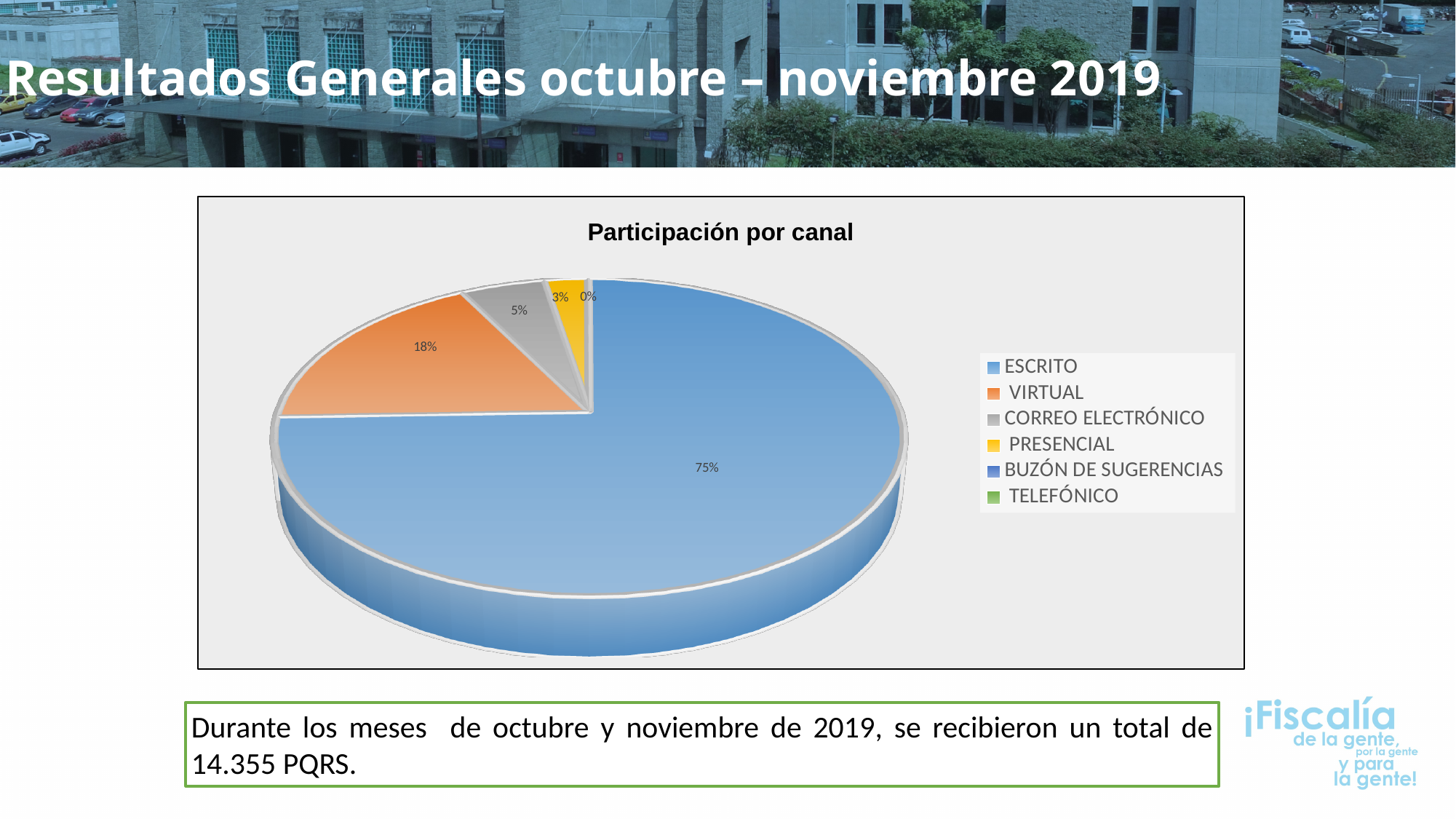
Which channel has the largest share of the pie? ESCRITO What share of the pie does VIRTUAL have? 18% What kind of chart is shown on the slide? pie chart What share of the pie does PRESENCIAL have? 3% What is the difference between the CORREO ELECTRÓNICO share and the PRESENCIAL share? 2% What share of the pie does CORREO ELECTRÓNICO have? 5% How many entries does the legend list? 6 Which is larger, the share for VIRTUAL or the share for CORREO ELECTRÓNICO? VIRTUAL What share of the pie does ESCRITO have? 75% Which colour represents VIRTUAL in the chart? orange What is the title of the chart? Participación por canal What is the difference between the ESCRITO share and the VIRTUAL share? 57%